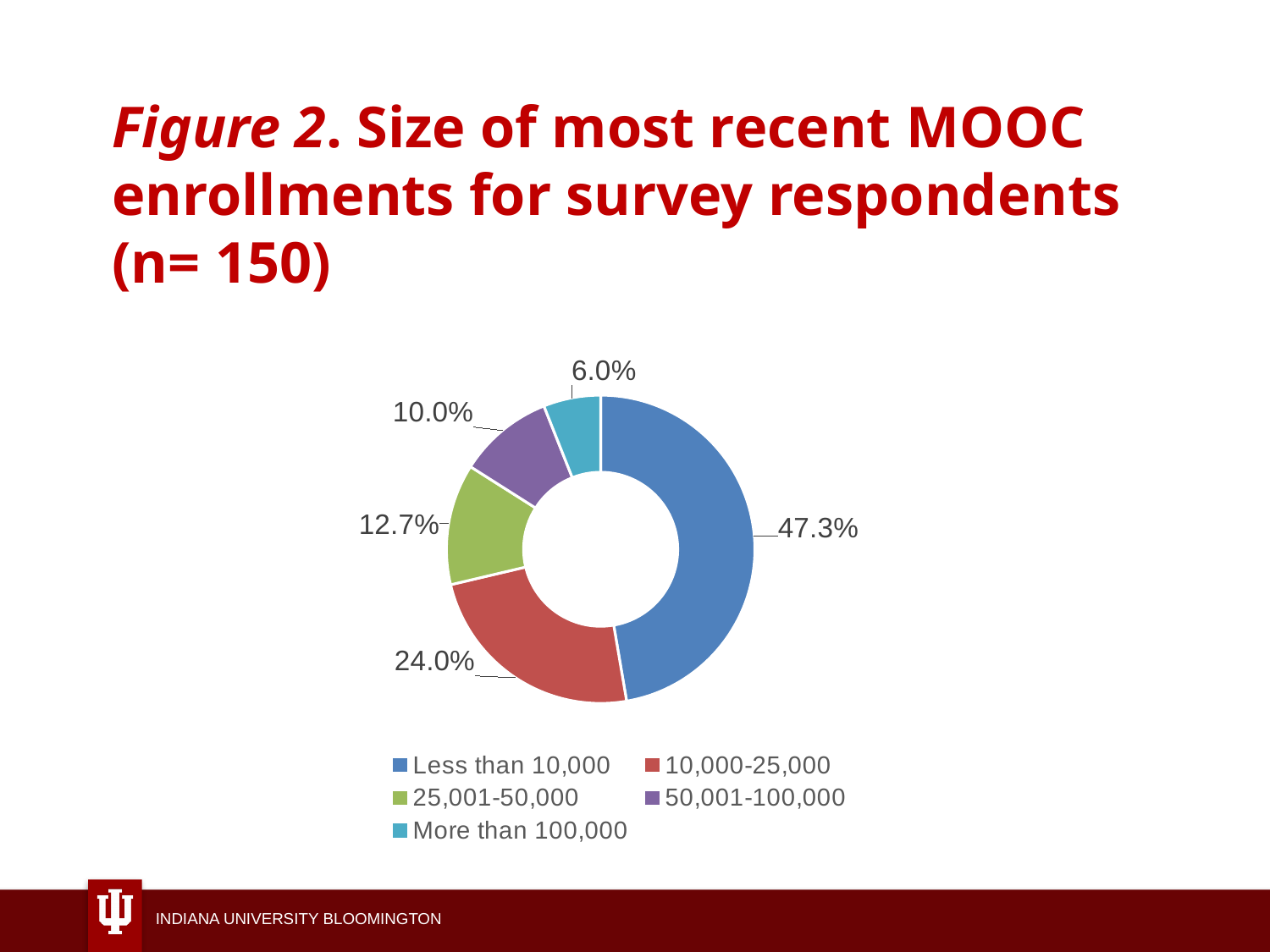
What is the difference in percentage points between the 'Less than 10,000' and '10,000-25,000' categories? 23.3 What share of respondents reported enrollments of 10,000-25,000? 24.0% How many enrollment size categories are shown in the chart? 5 Which category has a larger share: 50,001-100,000 or 25,001-50,000? 25,001-50,000 What colour represents the '10,000-25,000' category in the chart? Red Which enrollment size category has the smallest share? More than 100,000 Which enrollment size category has the largest share? Less than 10,000 What share of respondents reported enrollments of more than 100,000? 6.0% What is the combined share of the '50,001-100,000' and 'More than 100,000' categories? 16.0% What share of respondents reported enrollments of less than 10,000? 47.3% What kind of chart is shown on the slide? Doughnut chart What share of respondents reported enrollments of 25,001-50,000? 12.7%